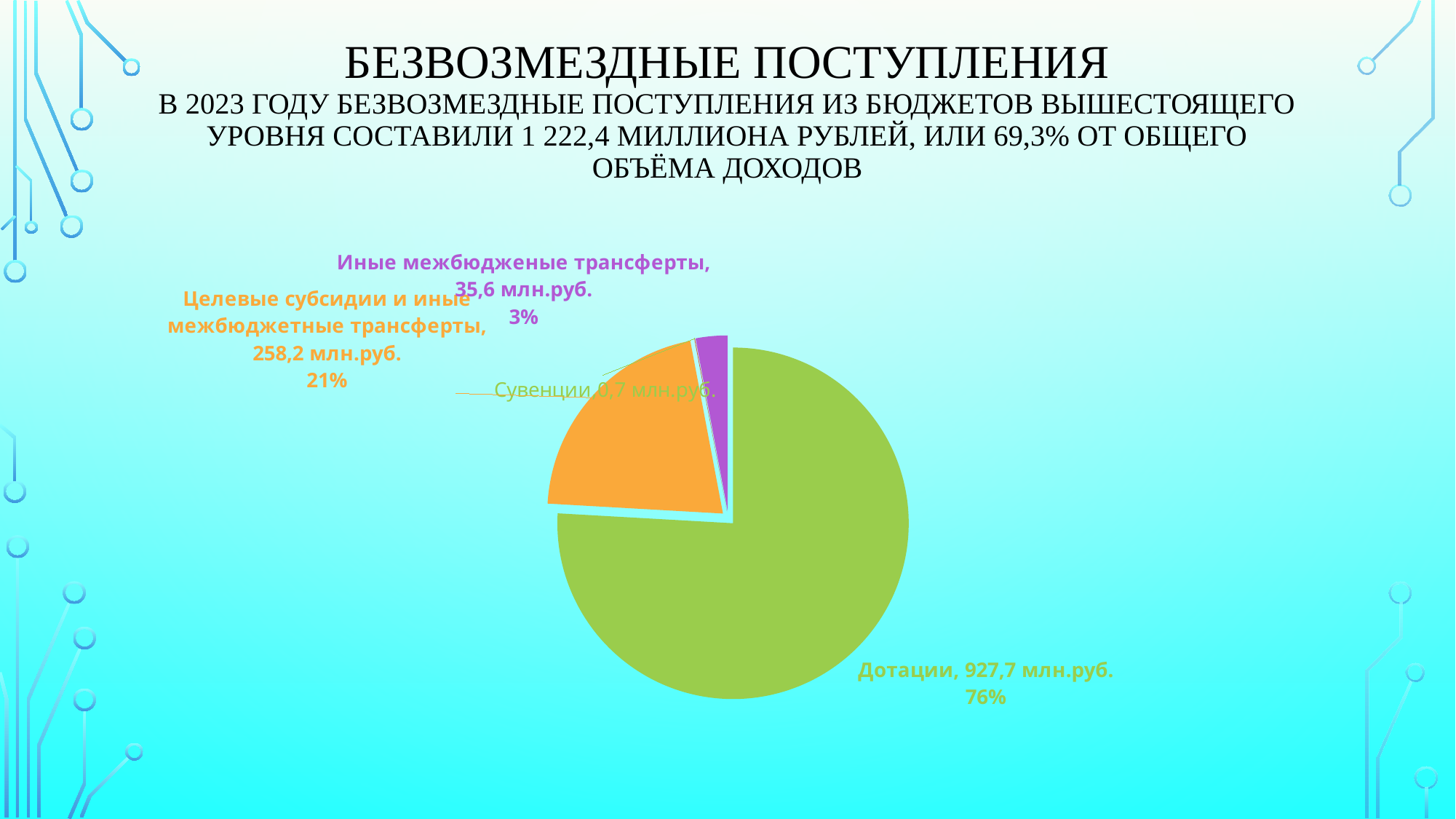
How many slices does the pie chart have? 4 What is the value for Дотации? 927,7 млн.руб. Which category has the smallest slice of the pie? Субвенции Which is larger: Иные межбюдженые трансферты or Субвенции? Иные межбюдженые трансферты Which category has the largest slice of the pie? Дотации What is the value for Субвенции? 0,7 млн.руб. What is the value for Иные межбюдженые трансферты? 35,6 млн.руб. What is the value for Целевые субсидии и иные межбюджетные трансферты? 258,2 млн.руб. What share of the pie does Дотации represent? 76% What is the difference between the values for Дотации and Целевые субсидии и иные межбюджетные трансферты? 669,5 млн.руб. What share of the pie does Целевые субсидии и иные межбюджетные трансферты represent? 21% What kind of chart is shown on the slide? pie chart